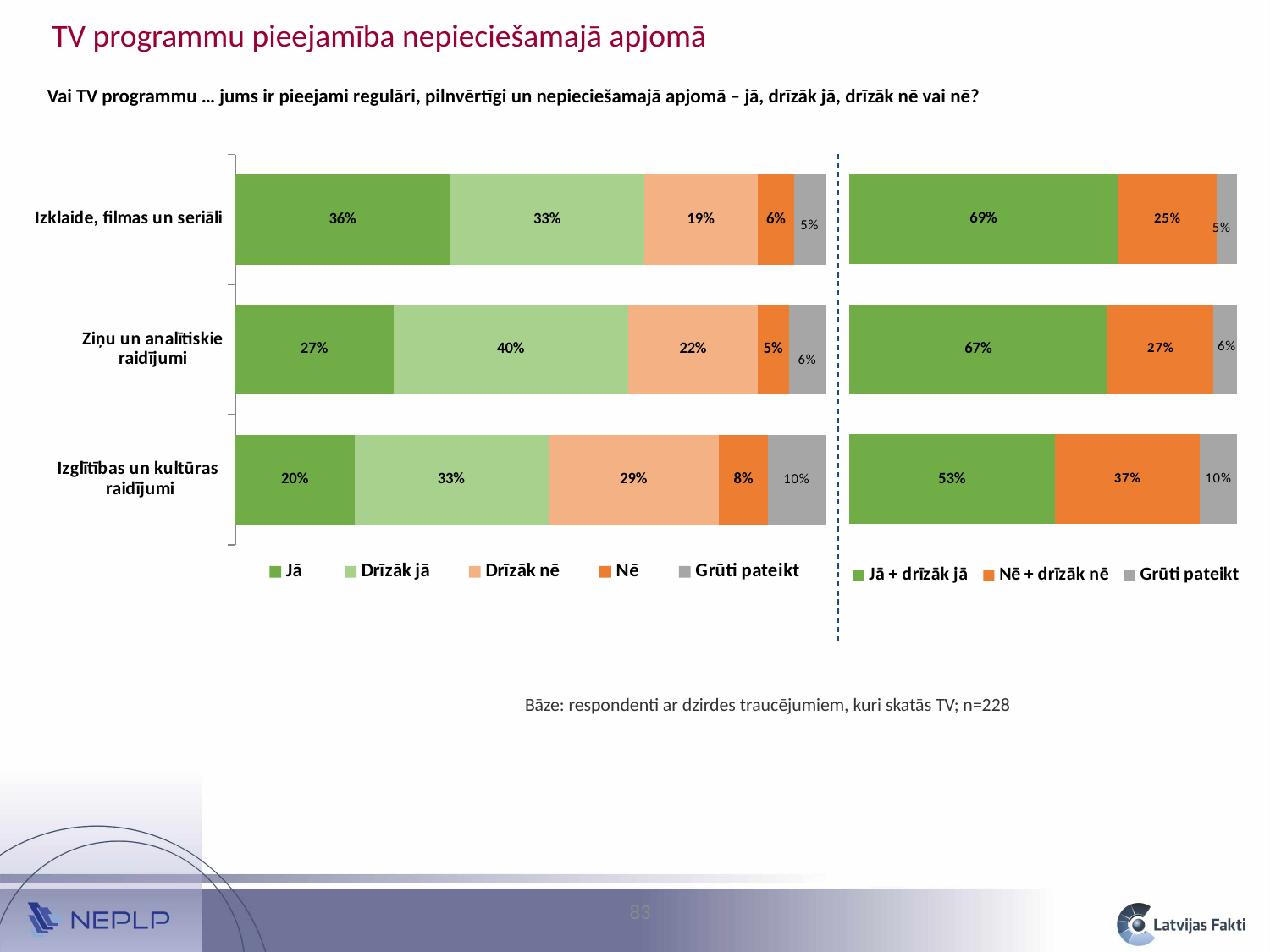
In the right chart, which category has the highest 'Jā + drīzāk jā' value? Izklaide, filmas un seriāli In the left chart, what is the 'Jā' value for 'Izklaide, filmas un seriāli'? 36% In the left chart, what is the 'Grūti pateikt' value for 'Izglītības un kultūras raidījumi'? 10% How many series does the legend of the left chart list? 5 What kind of chart is the left chart? Stacked bar chart How many series does the legend of the right chart list? 3 In the left chart, what is the difference between the 'Drīzāk nē' values for 'Izglītības un kultūras raidījumi' and 'Izklaide, filmas un seriāli'? 10% In the left chart, what is the 'Drīzāk jā' value for 'Ziņu un analītiskie raidījumi'? 40% How many categories are shown in the left chart? 3 In the right chart, which is larger: the 'Jā + drīzāk jā' value for 'Ziņu un analītiskie raidījumi' or for 'Izglītības un kultūras raidījumi'? Ziņu un analītiskie raidījumi In the left chart, which category has the lowest 'Jā' value? Izglītības un kultūras raidījumi In the right chart, what is the 'Nē + drīzāk nē' value for 'Izglītības un kultūras raidījumi'? 37%